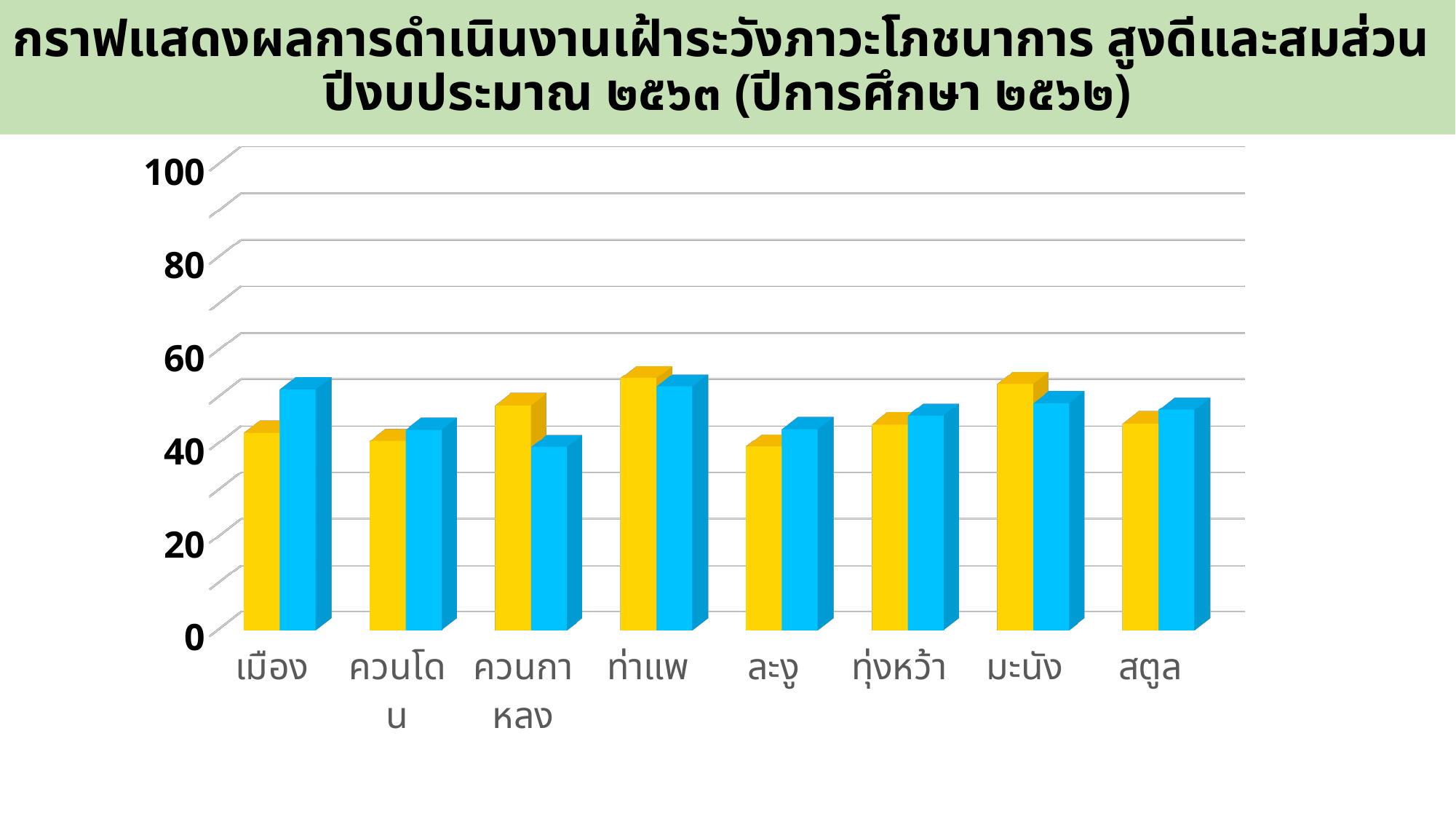
How many bar series (colours) are plotted for each category? 2 For ควนกาหลง, which bar is taller, the yellow one or the blue one? the yellow one How many categories are shown on the x axis of the chart? 8 Is the yellow bar for มะนัง greater or less than 20? greater Is the blue bar for ควนกาหลง greater or less than 60? less Is the yellow bar for ท่าแพ greater or less than 40? greater What two colours are used for the bars in the chart? yellow and blue Which yellow bar is taller, ละงู or ท่าแพ? ท่าแพ For เมือง, which bar is taller, the yellow one or the blue one? the blue one What kind of chart is shown on the slide? bar chart